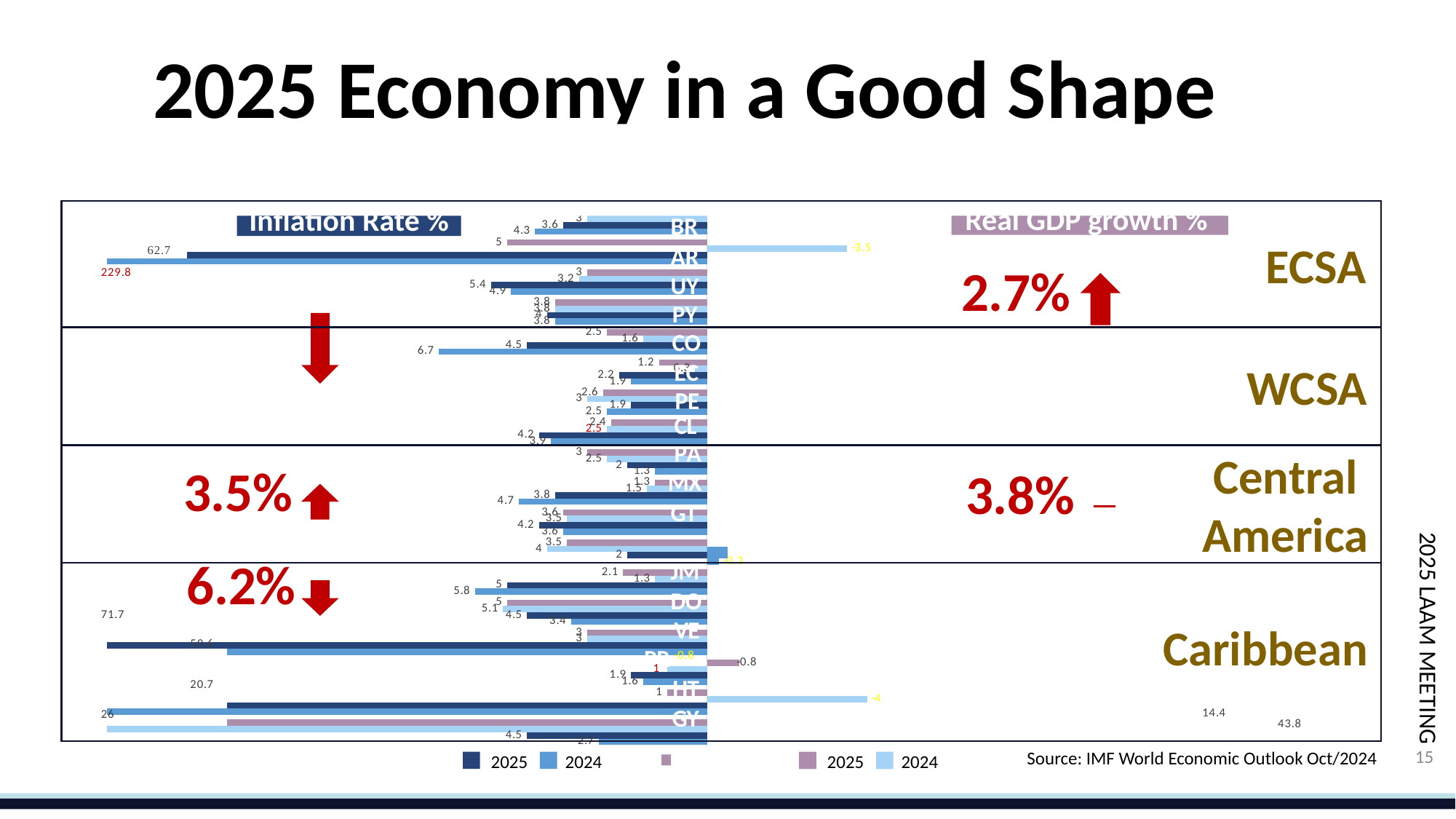
What is the 2024 inflation rate shown for AR? 229.8 What is the 2025 inflation rate shown for AR? 62.7 What is the 2024 real GDP growth value shown for HT? -4 What source is cited for the chart data? IMF World Economic Outlook Oct/2024 What real GDP growth percentage is shown for Central America? 3.8% What real GDP growth percentage is shown for the ECSA region? 2.7% What is the difference between AR's 2024 and 2025 inflation rates? 167.1 What is the 2024 real GDP growth value shown for AR? -3.5 What kind of chart is shown on the slide? bar chart What is the 2024 inflation rate shown for CO? 6.7 Which is larger for AR: the 2024 inflation rate or the 2025 inflation rate? 2024 Which country has the longest inflation rate bar on the chart? AR